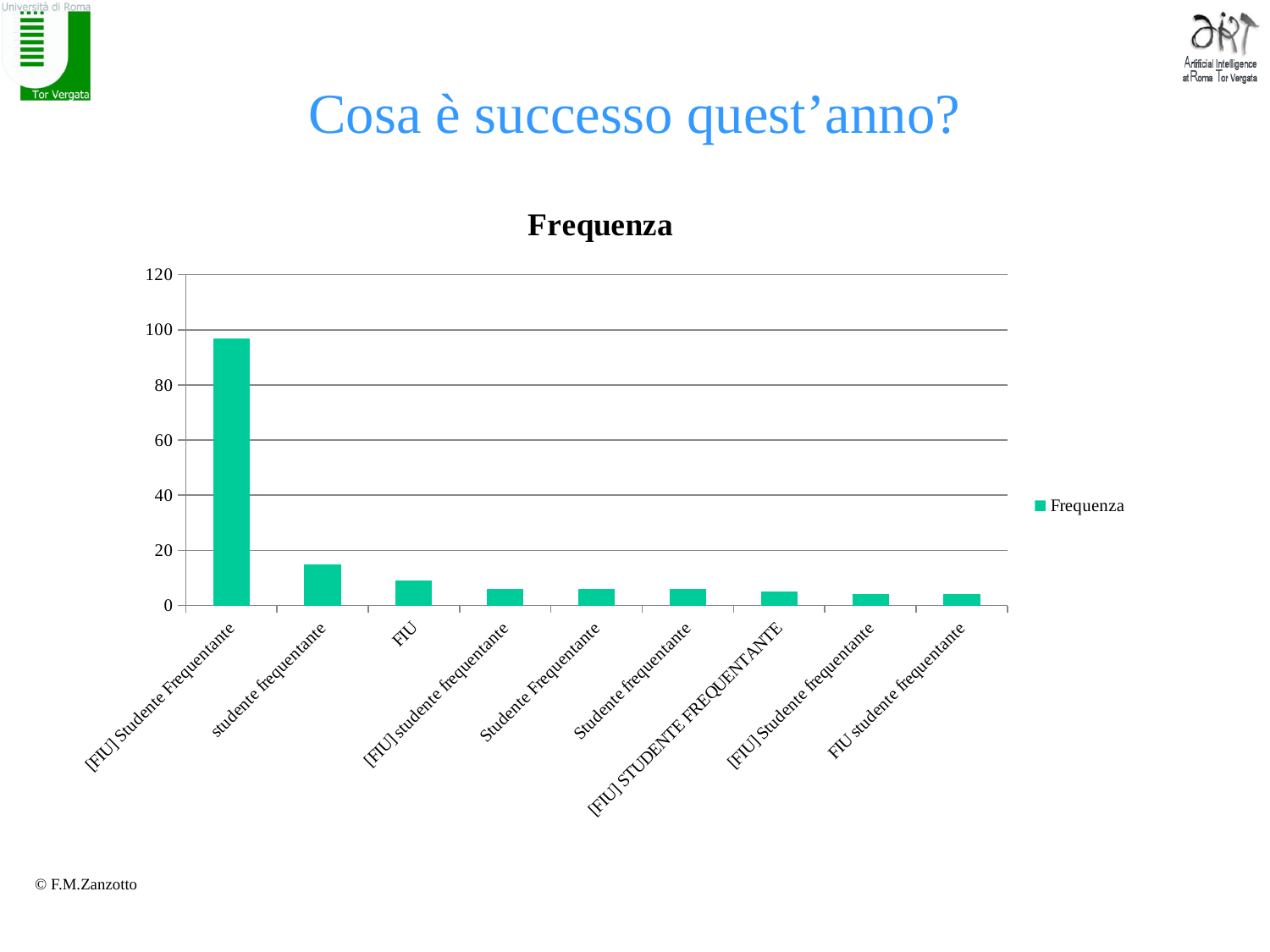
How many categories are shown on the x axis of the chart? 9 Which category has the highest value? [FIU] Studente Frequentante Is the value for FIU greater or less than 20? less What kind of chart is shown on the slide? bar chart Is the value for [FIU] Studente Frequentante greater or less than 80? greater Which is larger, the value for [FIU] Studente Frequentante or the value for studente frequentante? [FIU] Studente Frequentante What is the title of the chart? Frequenza Which is larger, the value for studente frequentante or the value for FIU? studente frequentante Is the value for studente frequentante greater or less than 20? less How many series does the legend list? 1 Do the values generally rise or fall from left to right along the x axis? fall What is the name of the series listed in the legend? Frequenza